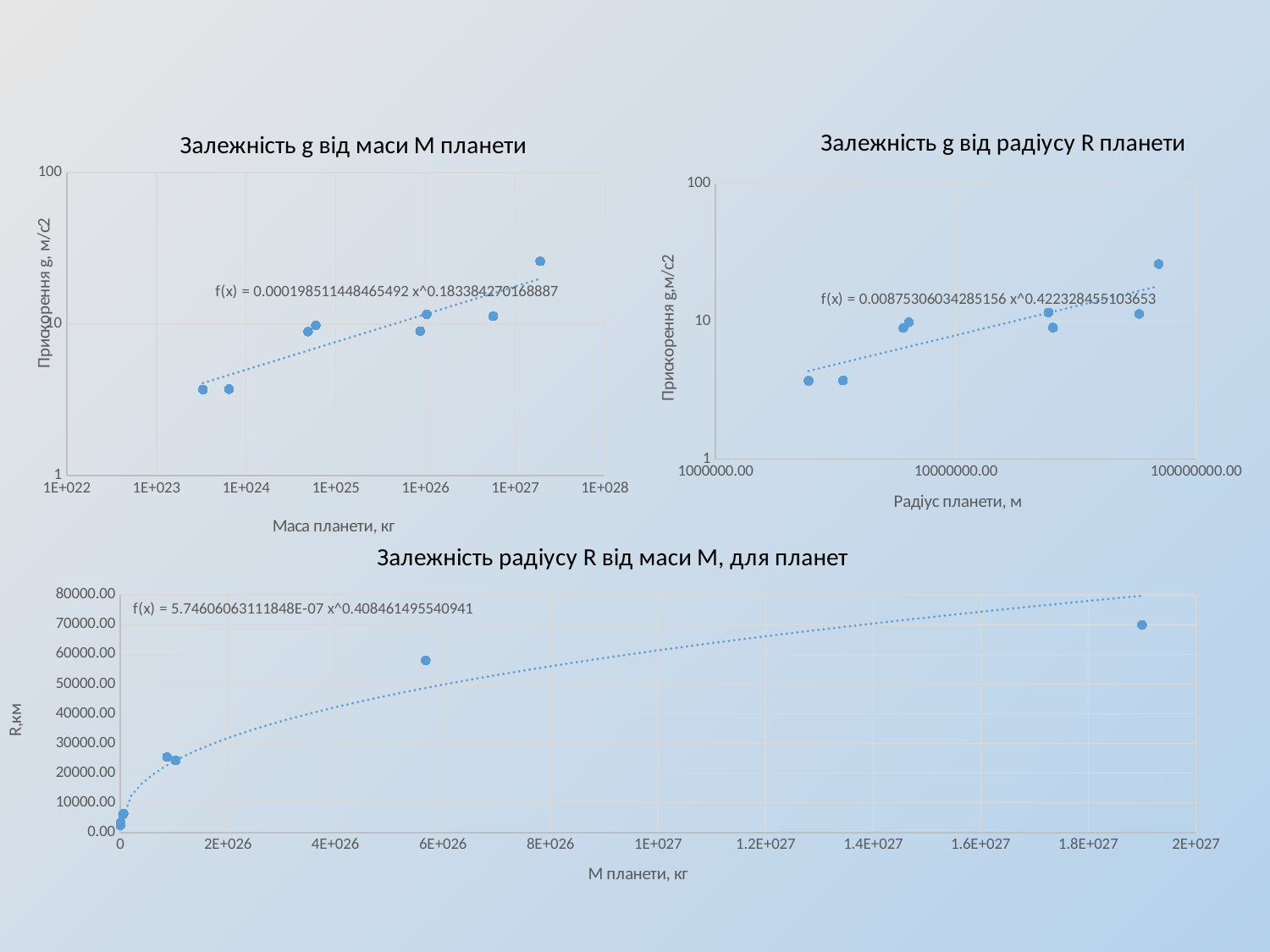
In the chart "Залежність g від радіусу R планети", do the g values rise or fall as the radius increases along the x axis? rise In the chart "Залежність радіусу R від маси M, для планет", do the R values rise or fall as the mass M increases along the x axis? rise What kind of chart is "Залежність g від маси M планети"? scatter chart In the chart "Залежність g від маси M планети", is the g value for the rightmost point greater or less than 10? greater In the chart "Залежність радіусу R від маси M, для планет", which has the larger R value: the point near 6E+026 kg or the rightmost point near 1.9E+027 kg? the rightmost point near 1.9E+027 kg In the chart "Залежність радіусу R від маси M, для планет", is the R value for the point near 6E+026 kg greater or less than 50000.00? greater What is the y-axis label of the chart "Залежність радіусу R від маси M, для планет"? R,км How many data points are plotted in the chart "Залежність g від маси M планети"? 8 In the chart "Залежність g від радіусу R планети", is the g value for the leftmost point greater or less than 10? less What is the x-axis label of the chart "Залежність g від радіусу R планети"? Радіус планети, м